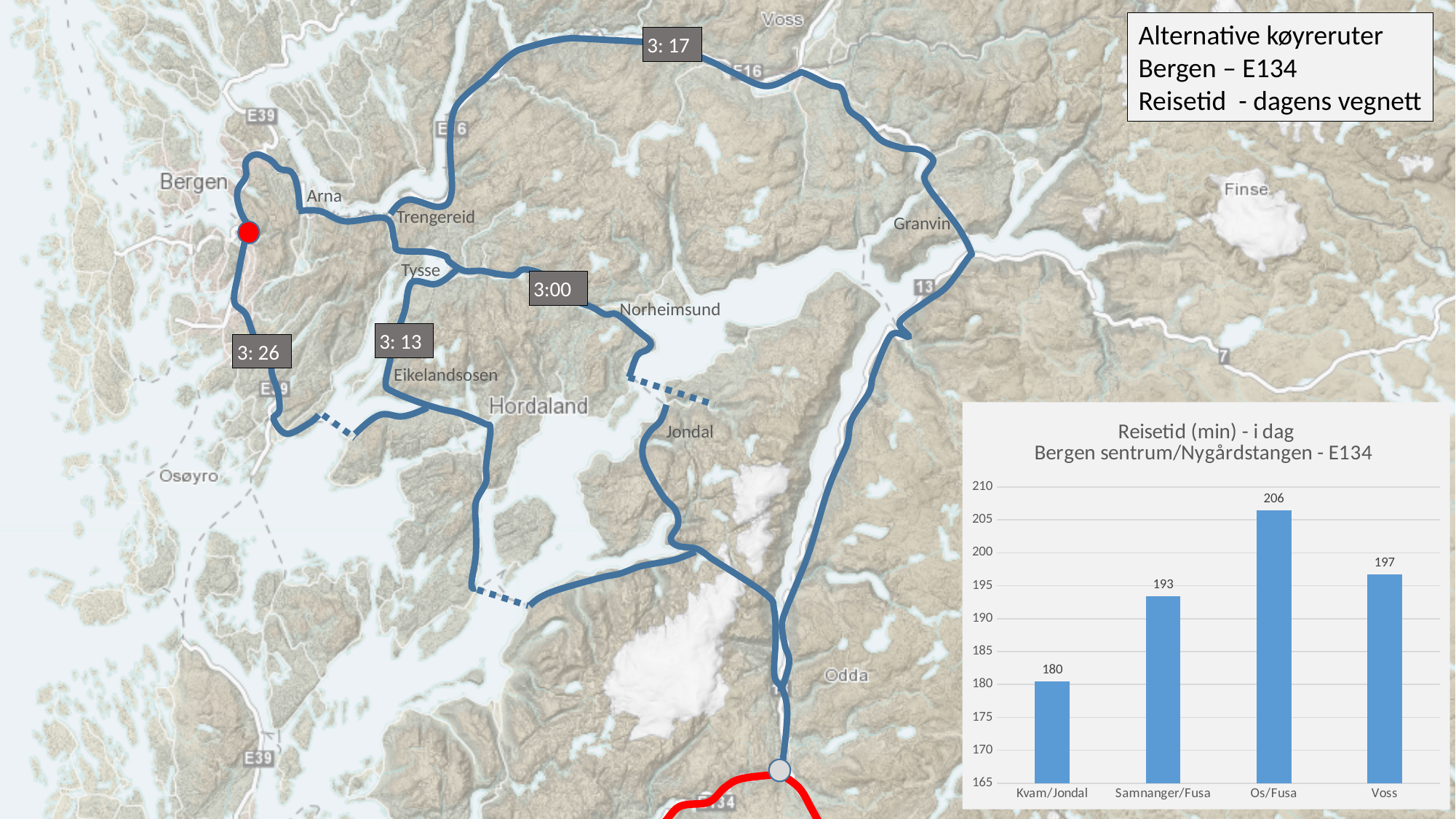
What kind of chart is shown on the slide? Bar chart What is the difference in travel time between Os/Fusa and Kvam/Jondal? 26 What is the title of the chart? Reisetid (min) - i dag Bergen sentrum/Nygårdstangen - E134 What is the travel time in minutes for Os/Fusa? 206 What is the travel time in minutes for Voss? 197 Which route has the highest travel time? Os/Fusa How many routes are shown in the chart? 4 Which has a longer travel time, Samnanger/Fusa or Voss? Voss What is the travel time in minutes for Kvam/Jondal? 180 What is the travel time in minutes for Samnanger/Fusa? 193 Is the value for Samnanger/Fusa greater or less than 190? greater Which route has the lowest travel time? Kvam/Jondal